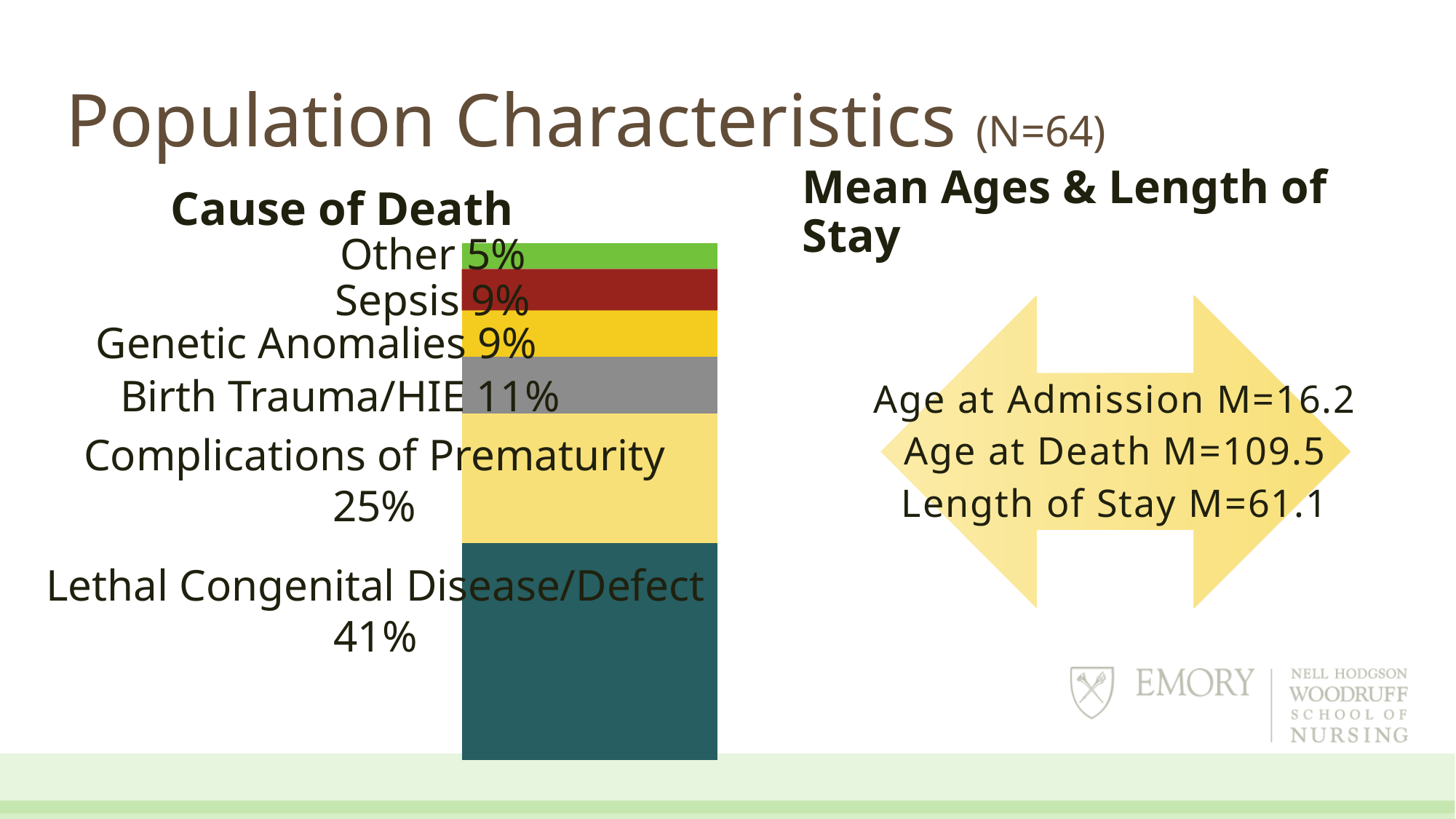
In the Cause of Death chart, what percentage is shown for Lethal Congenital Disease/Defect? 41% What kind of chart is used to show Cause of Death? Stacked bar chart In the Cause of Death chart, what is the total of all the segments in the stacked bar? 100% In the Cause of Death chart, what percentage is shown for Birth Trauma/HIE? 11% In the Cause of Death chart, what percentage is shown for Complications of Prematurity? 25% In the Cause of Death chart, what is the difference in percentage points between Lethal Congenital Disease/Defect and Complications of Prematurity? 16 In the Cause of Death chart, what percentage is shown for Sepsis? 9% In the Cause of Death chart, what colour is the Sepsis segment? Dark red In the Cause of Death chart, which cause of death has the smallest share? Other In the Cause of Death chart, which is larger: Birth Trauma/HIE or Genetic Anomalies? Birth Trauma/HIE How many cause-of-death categories are shown in the stacked bar? 6 In the Cause of Death chart, which cause of death has the largest share? Lethal Congenital Disease/Defect